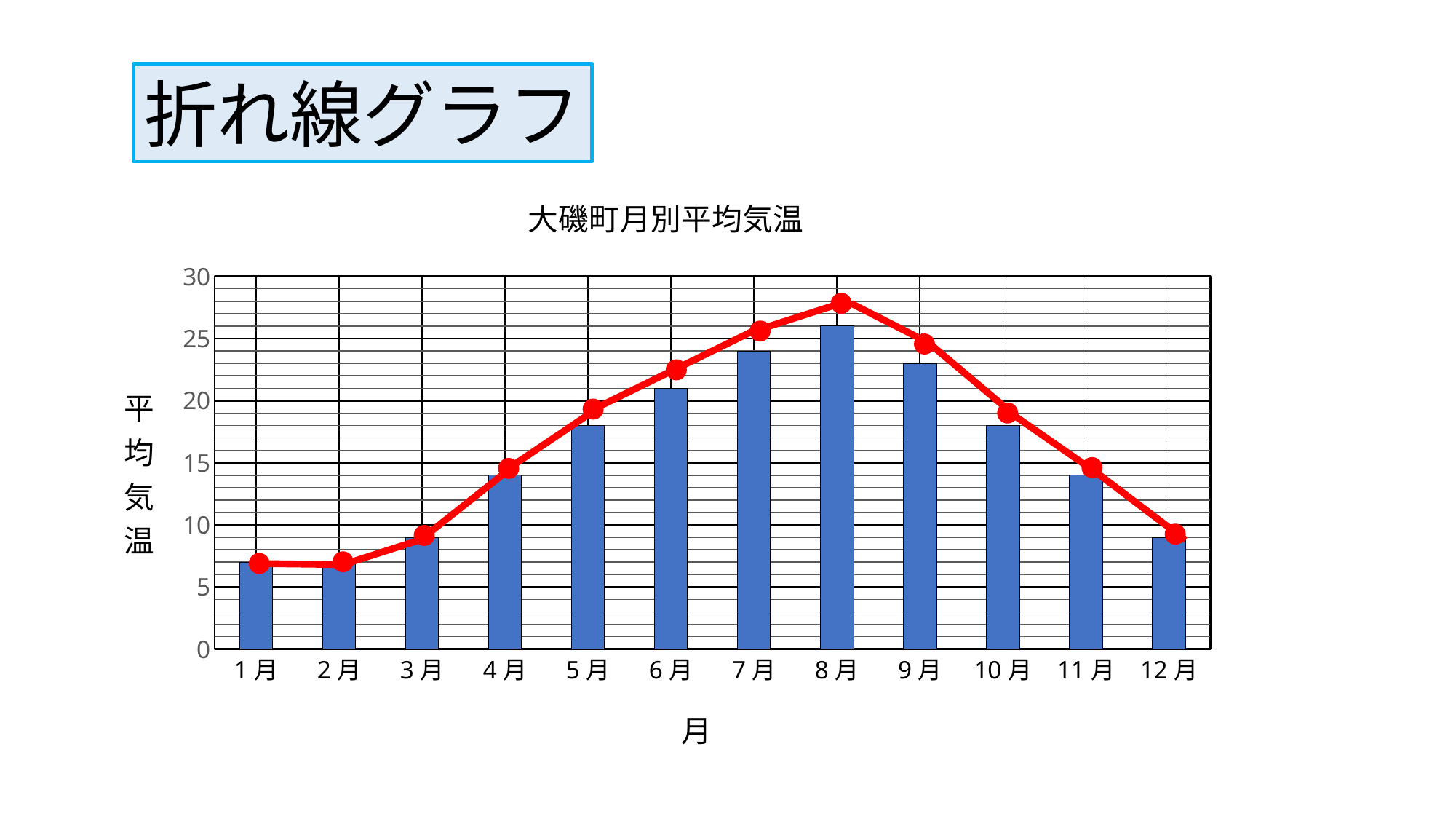
Which month has the highest bar in the chart? 8月 Is the bar value for 10月 greater or less than 20? less Which has the larger bar, 9月 or 11月? 9月 Is the bar value for 9月 greater or less than 20? greater Is the red line point for 8月 greater or less than 25? greater Which has the larger bar, 7月 or 5月? 7月 What is the label on the vertical axis of the chart? 平均気温 What is the title of the chart? 大磯町月別平均気温 Do the values rise or fall from 1月 to 8月? rise How many months are shown on the x axis of the chart? 12